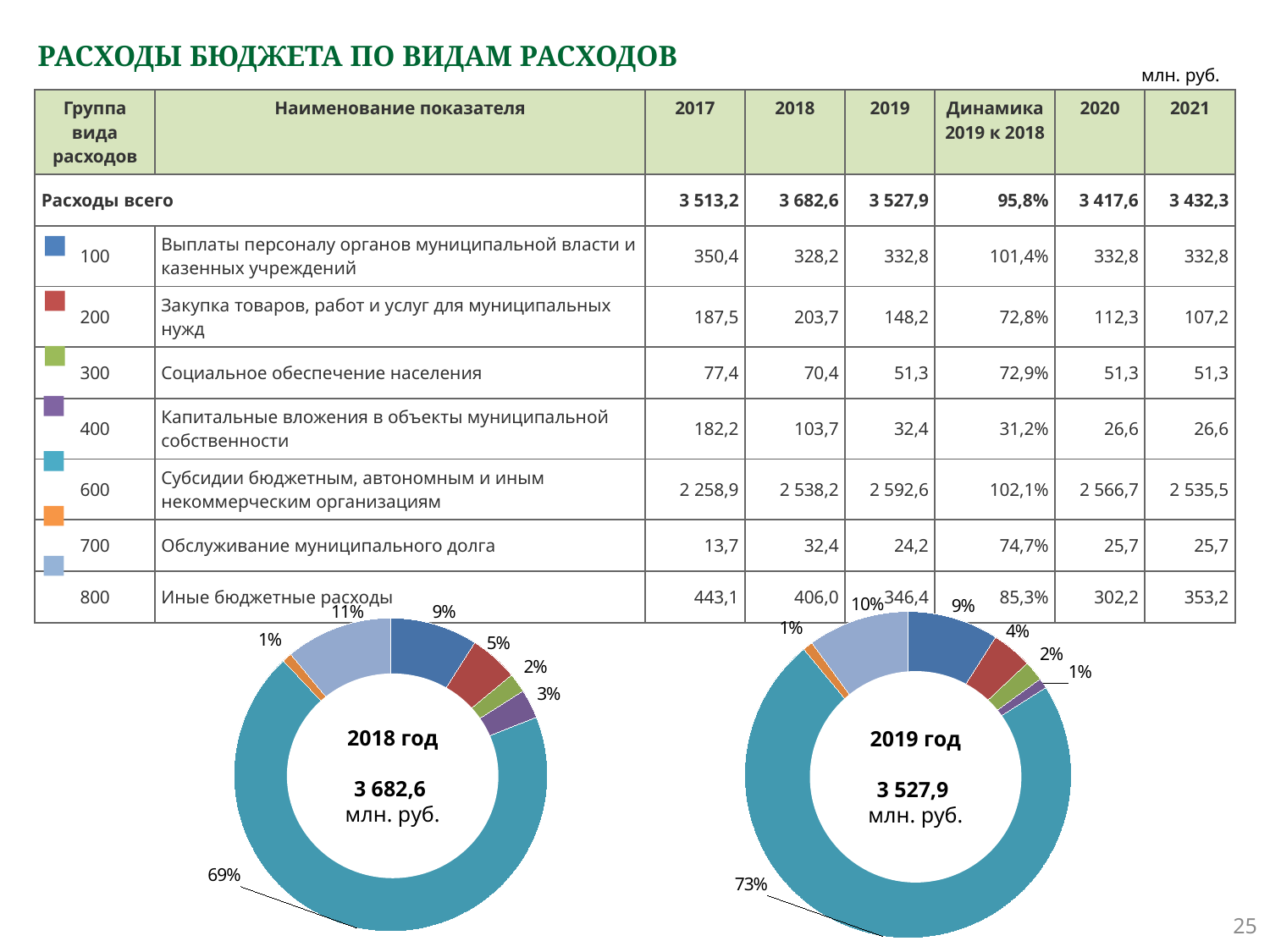
In the 2018 год chart, what share is shown for the red slice (group 200)? 5% Which chart shows a larger share for the teal slice (group 600): 2018 год or 2019 год? 2019 год In the 2019 год chart, what share is shown for the dark blue slice (group 100)? 9% In the 2018 год chart, what share is shown for the dark blue slice (group 100)? 9% How many slices does the 2019 год chart have? 7 What total amount is printed in the centre of the 2018 год chart? 3 682,6 млн. руб. In the 2018 год chart, what share does the largest slice have? 69% What is the difference between the teal slice share in the 2019 год chart and in the 2018 год chart? 4 percentage points In the 2019 год chart, what share does the largest slice have? 73% What kind of chart is used for the 2018 год chart? Pie (donut) chart